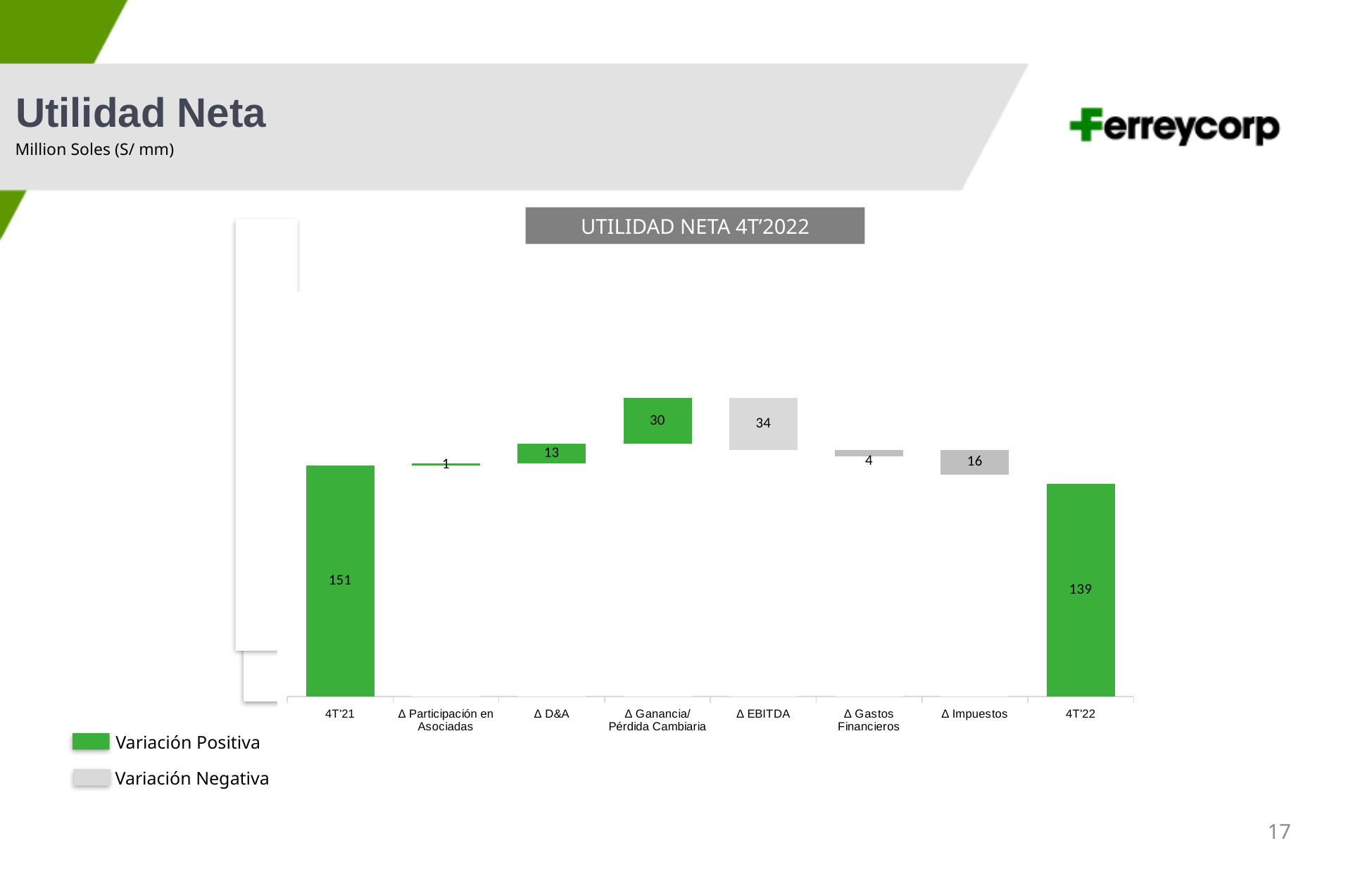
What kind of chart is shown on the slide? Bar chart (waterfall) What is the value shown for Δ EBITDA? 34 What is the value for 4T'22 in the Utilidad Neta 4T'2022 chart? 139 What is the difference between the 4T'21 value and the 4T'22 value? 12 Which is larger, the value for Δ D&A or the value for Δ Gastos Financieros? Δ D&A What is the value shown for Δ Impuestos? 16 Which category has the smallest value in the chart? Δ Participación en Asociadas What is the value shown for Δ Ganancia/Pérdida Cambiaria? 30 Which category has the highest value in the chart? 4T'21 What is the value for 4T'21 in the Utilidad Neta 4T'2022 chart? 151 How many categories are shown on the x axis of the chart? 8 What colour does the legend use for Variación Negativa? Grey